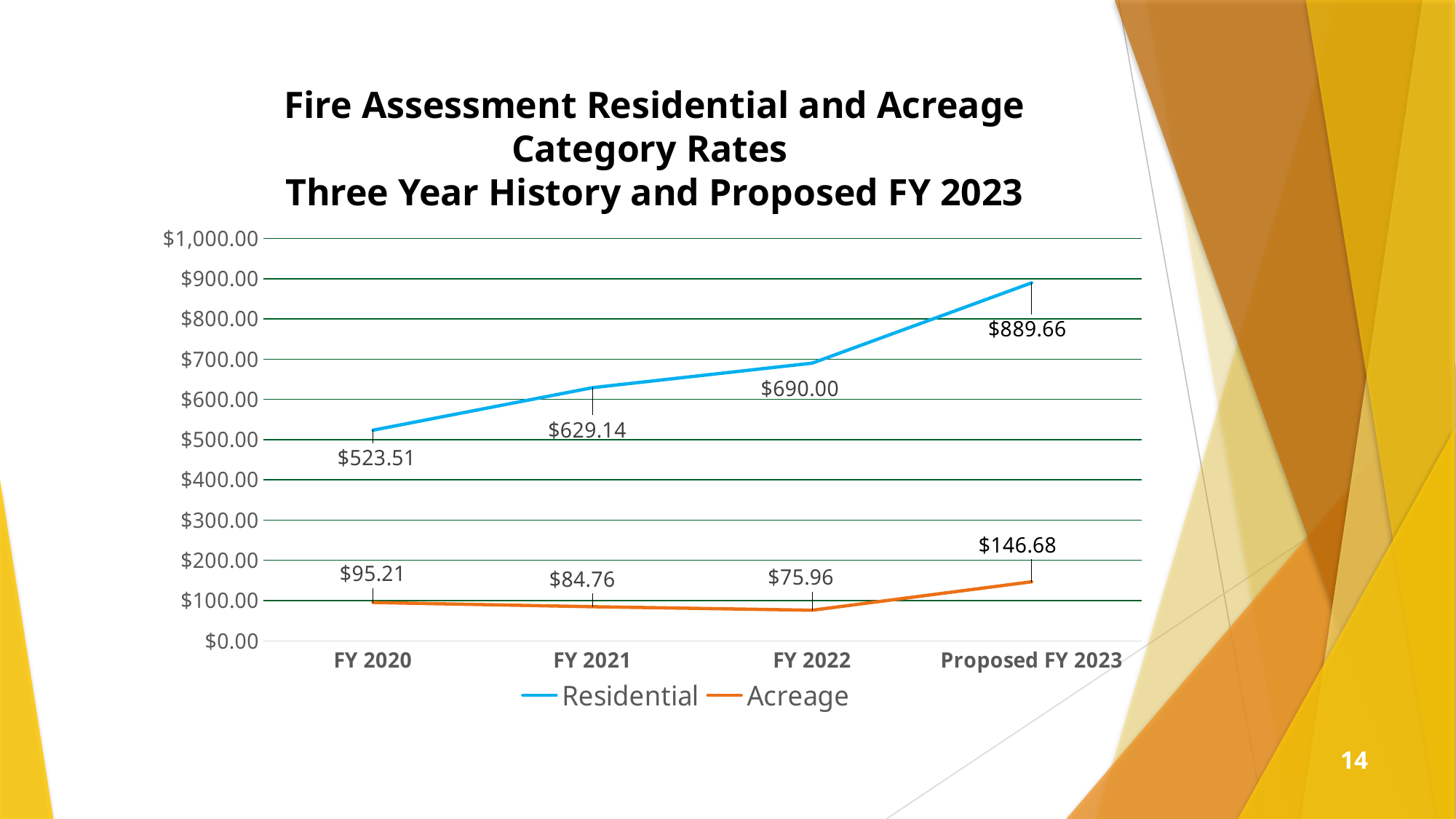
In which year is the Acreage rate lowest? FY 2022 What is the Residential rate for FY 2020? $523.51 What is the Residential rate for FY 2022? $690.00 In which year is the Residential rate highest? Proposed FY 2023 What is the difference between the Residential rate for Proposed FY 2023 and FY 2022? $199.66 What kind of chart is this? Line chart What is the Acreage rate for Proposed FY 2023? $146.68 Does the Residential rate rise or fall from FY 2020 to Proposed FY 2023? Rise Which is larger, the Acreage rate for FY 2020 or for FY 2021? FY 2020 How many years are shown on the x axis? 4 How many series does the legend list? 2 What is the Acreage rate for FY 2021? $84.76